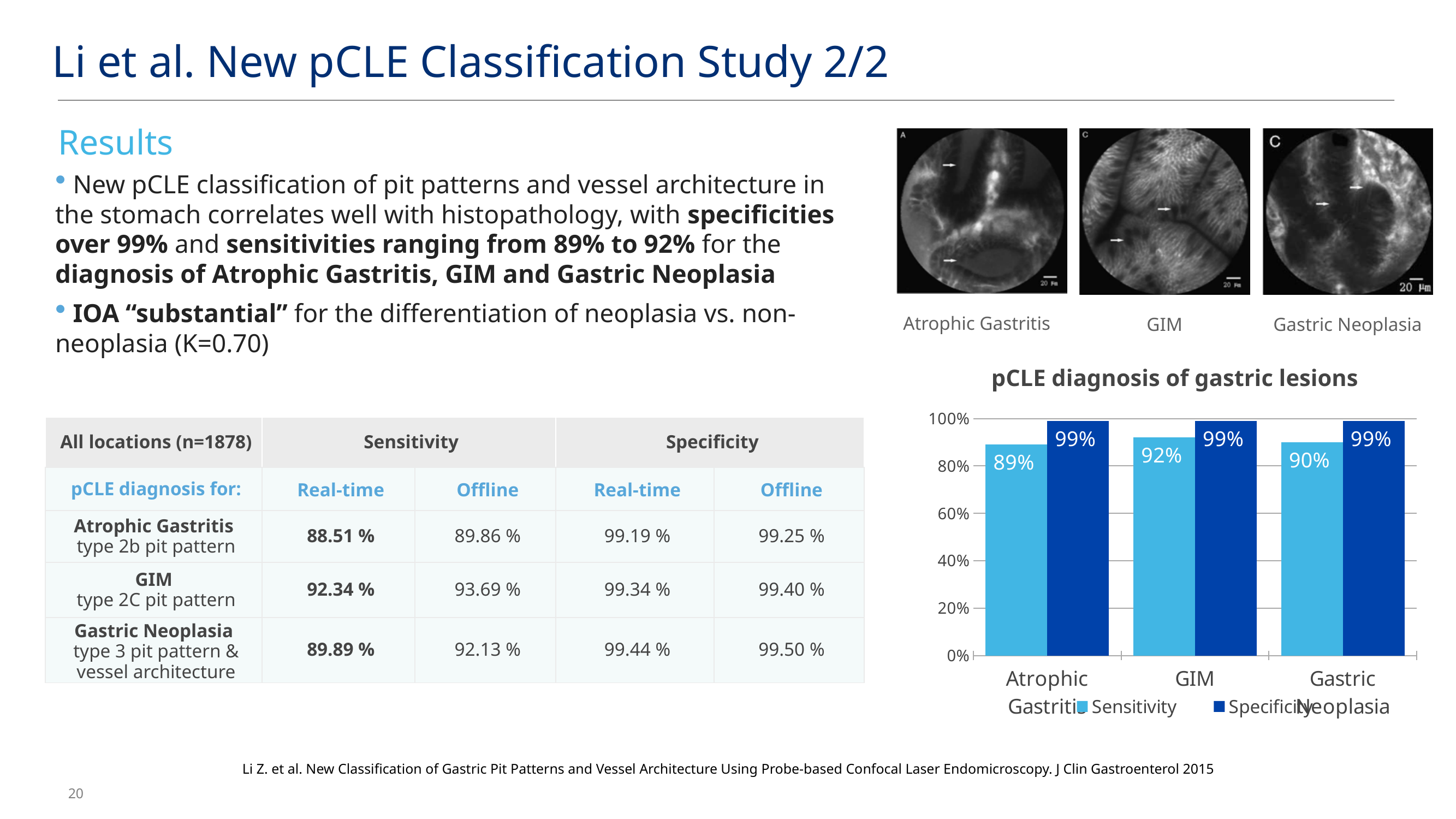
What is the title of the chart? pCLE diagnosis of gastric lesions What is the difference between the Specificity and Sensitivity values for Atrophic Gastritis in the chart? 10% Which category has the lowest Sensitivity in the chart? Atrophic Gastritis Which category has the highest Sensitivity in the chart? GIM How many categories are shown on the x axis of the chart? 3 Which is larger for GIM in the chart, Sensitivity or Specificity? Specificity What is the Sensitivity value for Atrophic Gastritis in the chart? 89% What type of chart is shown on the slide? bar chart How many series does the chart legend list? 2 What is the Specificity value for Gastric Neoplasia in the chart? 99% What is the Sensitivity value for GIM in the chart? 92% Is the Sensitivity value for Gastric Neoplasia greater or less than 80%? greater